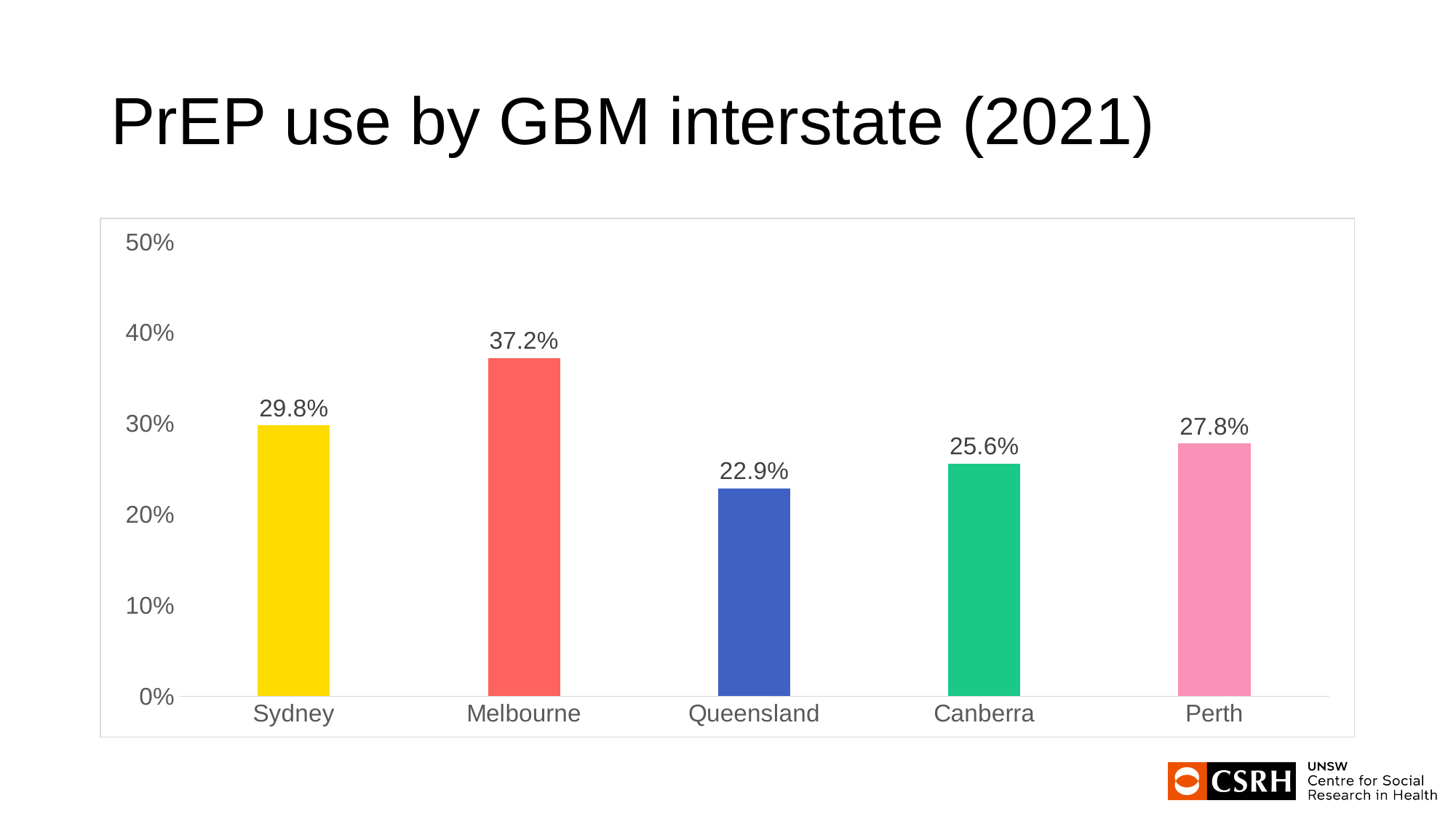
What is the difference in PrEP use between Melbourne and Sydney? 7.4% Which location has the highest PrEP use? Melbourne How many locations are shown in the chart? 5 What is the PrEP use value for Melbourne? 37.2% What is the PrEP use value for Perth? 27.8% Which has higher PrEP use, Perth or Canberra? Perth What type of chart is shown on the slide? Bar chart What is the PrEP use value for Sydney? 29.8% What is the PrEP use value for Queensland? 22.9% Is the value for Queensland greater or less than 30%? less What is the PrEP use value for Canberra? 25.6% Which location has the lowest PrEP use? Queensland